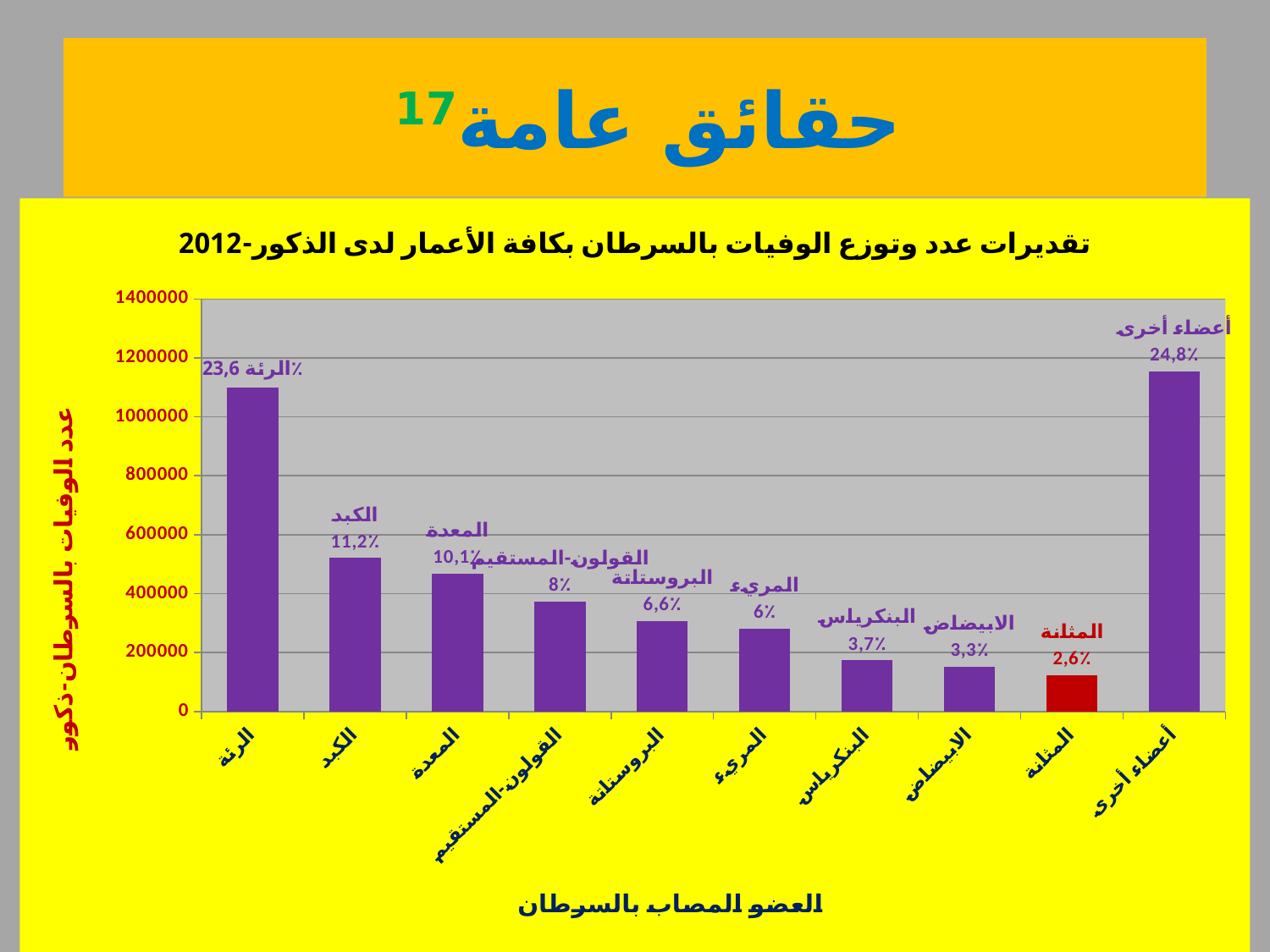
What is the difference between the percentage labels for الرئة (lung) and الكبد (liver)? 12,4% What percentage label is shown for المثانة (bladder) in the chart? 2,6% What percentage label is shown for الرئة (lung) in the chart? 23,6% What percentage label is shown for الكبد (liver) in the chart? 11,2% Which bar is taller, المعدة (stomach) or المريء (esophagus)? المعدة What percentage label is shown for البنكرياس (pancreas) in the chart? 3,7% Which bar in the chart is coloured red instead of purple? المثانة How many categories (organs) are plotted on the x axis of the chart? 10 What type of chart is shown on the slide? bar chart Which category has the lowest bar in the chart? المثانة Is the value for الرئة (lung) greater or less than 1000000? greater Which category has the highest bar in the chart? أعضاء أخرى